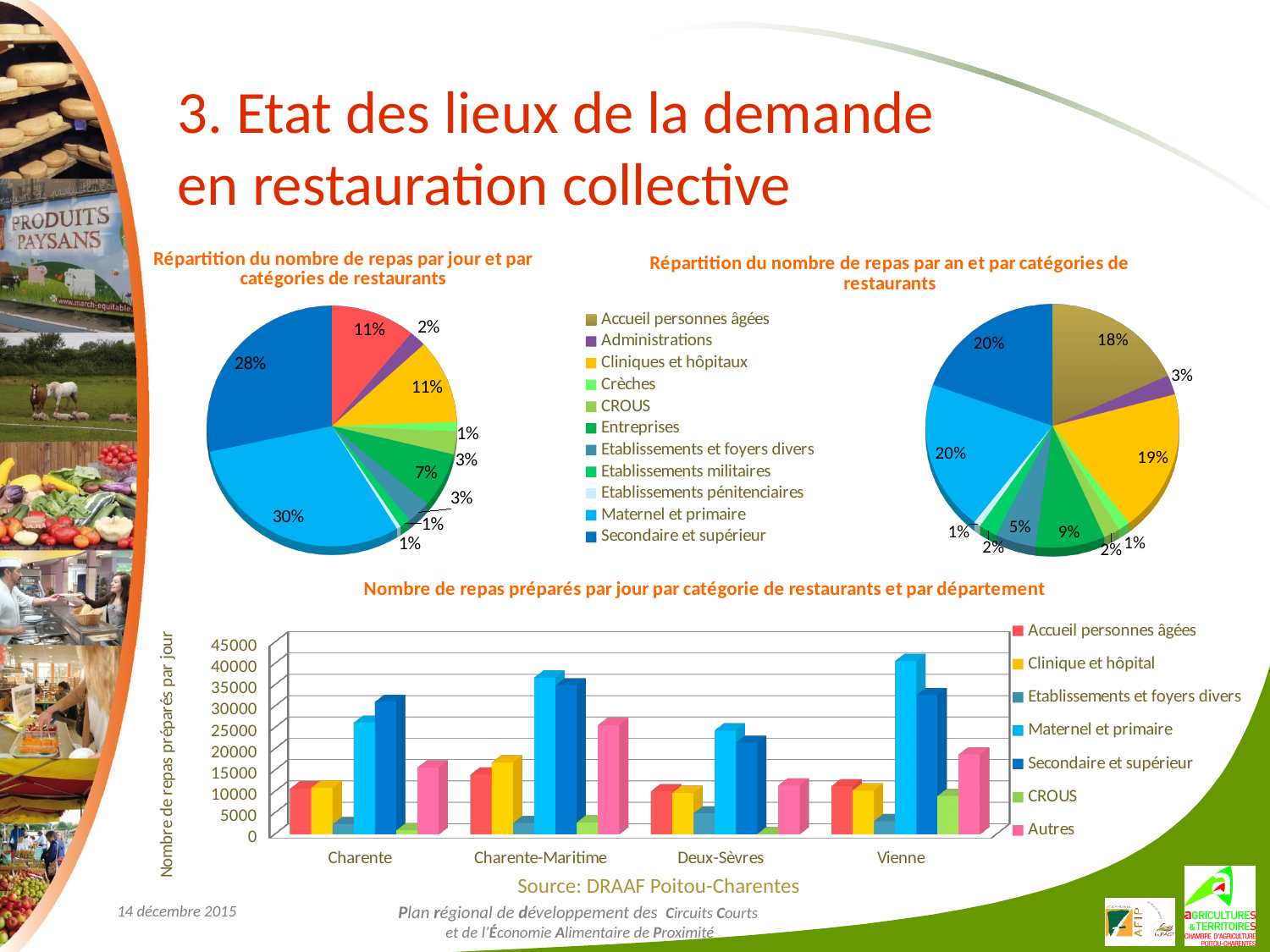
In the bottom bar chart, is the value for Secondaire et supérieur in Charente greater or less than 25000? greater In the bottom bar chart, how many départements are shown on the x axis? 4 What kind of chart is the bottom chart titled 'Nombre de repas préparés par jour par catégorie de restaurants et par département'? bar chart In the bottom bar chart, which is larger: Maternel et primaire in Charente-Maritime or Maternel et primaire in Deux-Sèvres? Charente-Maritime In the bottom bar chart, is the value for Maternel et primaire in Vienne greater or less than 35000? greater In the bottom bar chart, which département has the highest Maternel et primaire bar? Vienne In the left pie chart 'Répartition du nombre de repas par jour et par catégories de restaurants', what is the share for Secondaire et supérieur? 28% In the bottom bar chart, how many series does the legend list? 7 In the right pie chart 'Répartition du nombre de repas par an et par catégories de restaurants', what is the share for Cliniques et hôpitaux? 19% In the right pie chart 'Répartition du nombre de repas par an et par catégories de restaurants', what is the share for Accueil personnes âgées? 18% In the left pie chart 'Répartition du nombre de repas par jour et par catégories de restaurants', what is the share for Entreprises? 7% In the left pie chart 'Répartition du nombre de repas par jour et par catégories de restaurants', what is the share of the largest slice? 30%